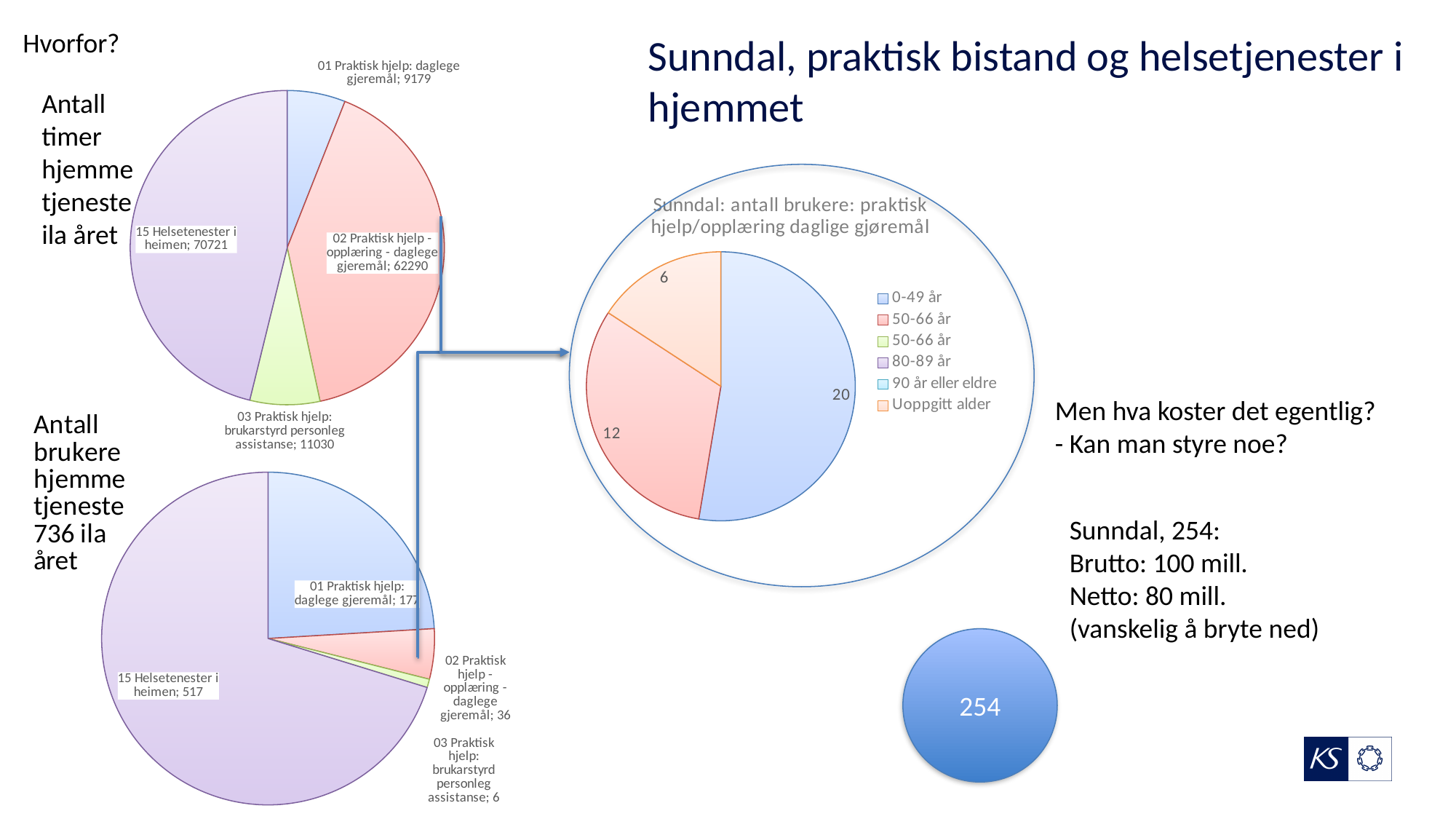
In the top-left pie chart (Antall timer hjemmetjeneste ila året), what is the difference between 03 Praktisk hjelp: brukarstyrd personleg assistanse and 01 Praktisk hjelp: daglege gjeremål? 1851 In the pie chart titled 'Sunndal: antall brukere: praktisk hjelp/opplæring daglige gjøremål', what is the difference between the 0-49 år slice and the Uoppgitt alder slice? 14 In the top-left pie chart (Antall timer hjemmetjeneste ila året), what is the value for 02 Praktisk hjelp - opplæring - daglege gjeremål? 62290 In the top-left pie chart (Antall timer hjemmetjeneste ila året), how many hours are shown for 15 Helsetenester i heimen? 70721 In the bottom-left pie chart (Antall brukere hjemmetjeneste 736 ila året), which is larger: 02 Praktisk hjelp - opplæring - daglege gjeremål or 03 Praktisk hjelp: brukarstyrd personleg assistanse? 02 Praktisk hjelp - opplæring - daglege gjeremål In the pie chart titled 'Sunndal: antall brukere: praktisk hjelp/opplæring daglige gjøremål', how many entries does the legend list? 6 What kind of chart is the top-left chart (Antall timer hjemmetjeneste ila året)? Pie chart In the pie chart titled 'Sunndal: antall brukere: praktisk hjelp/opplæring daglige gjøremål', what is the value for 0-49 år? 20 In the bottom-left pie chart (Antall brukere hjemmetjeneste 736 ila året), how many users are shown for 01 Praktisk hjelp: daglege gjeremål? 177 In the top-left pie chart (Antall timer hjemmetjeneste ila året), which category has the smallest value? 01 Praktisk hjelp: daglege gjeremål In the bottom-left pie chart (Antall brukere hjemmetjeneste 736 ila året), which category has the largest value? 15 Helsetenester i heimen In the bottom-left pie chart (Antall brukere hjemmetjeneste 736 ila året), how many categories are shown? 4